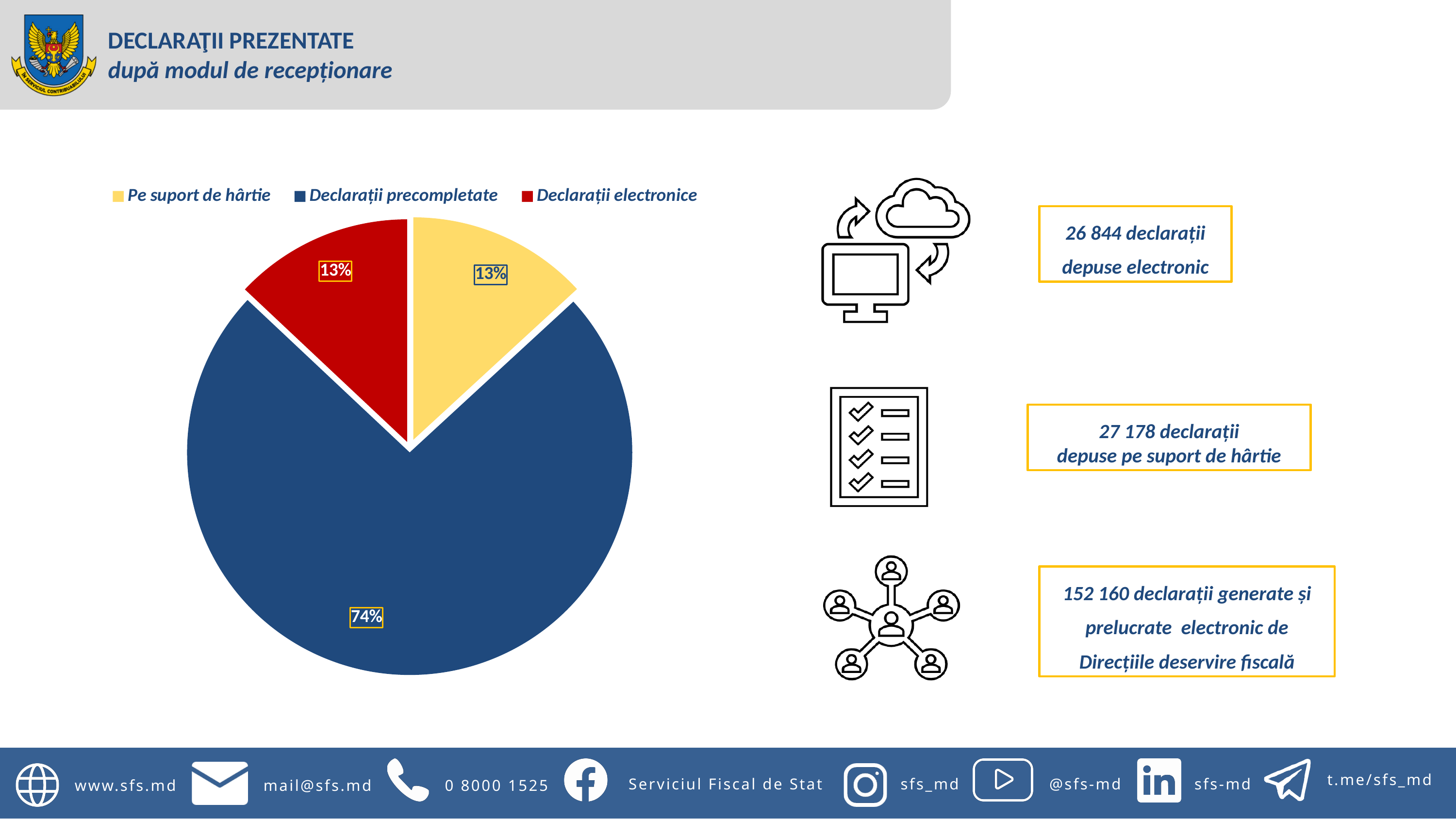
What share of the pie does "Declarații precompletate" represent? 74% What type of chart is shown on the slide? pie chart Which is larger: the slice for "Declarații precompletate" or the slice for "Pe suport de hârtie"? Declarații precompletate How many entries does the legend list? 3 Which category has the largest slice of the pie? Declarații precompletate What colour is the slice for "Pe suport de hârtie"? yellow How many slices does the pie chart have? 3 What is the difference in percentage points between "Declarații precompletate" and "Declarații electronice"? 61 What colour is the slice for "Declarații electronice"? red What is the combined share of "Pe suport de hârtie" and "Declarații electronice"? 26% What share of the pie does "Pe suport de hârtie" represent? 13% What share of the pie does "Declarații electronice" represent? 13%